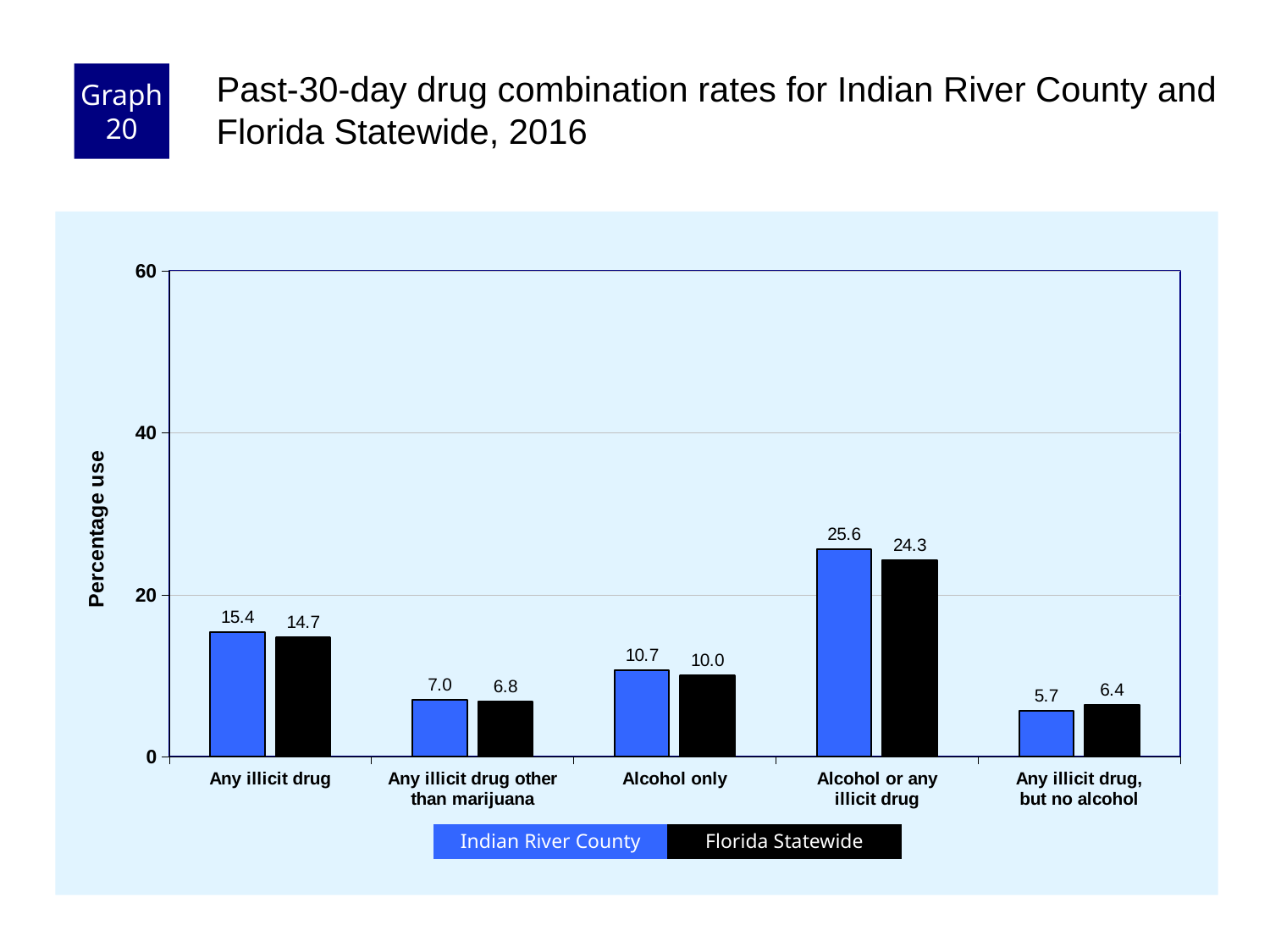
What is the difference between the Indian River County and Florida Statewide values for Alcohol or any illicit drug? 1.3 Which category has the lowest Indian River County value? Any illicit drug, but no alcohol What is the Florida Statewide value for Any illicit drug, but no alcohol? 6.4 Is the Florida Statewide value for Alcohol or any illicit drug greater or less than 20? greater Which category has the highest Florida Statewide value? Alcohol or any illicit drug What is the Indian River County value for Alcohol only? 10.7 How many categories are shown on the x axis? 5 What is the Indian River County value for Any illicit drug other than marijuana? 7.0 How many series does the legend list? 2 What kind of chart is shown on the slide? bar chart What is the label of the y axis? Percentage use For Any illicit drug, which is larger: the Indian River County value or the Florida Statewide value? Indian River County